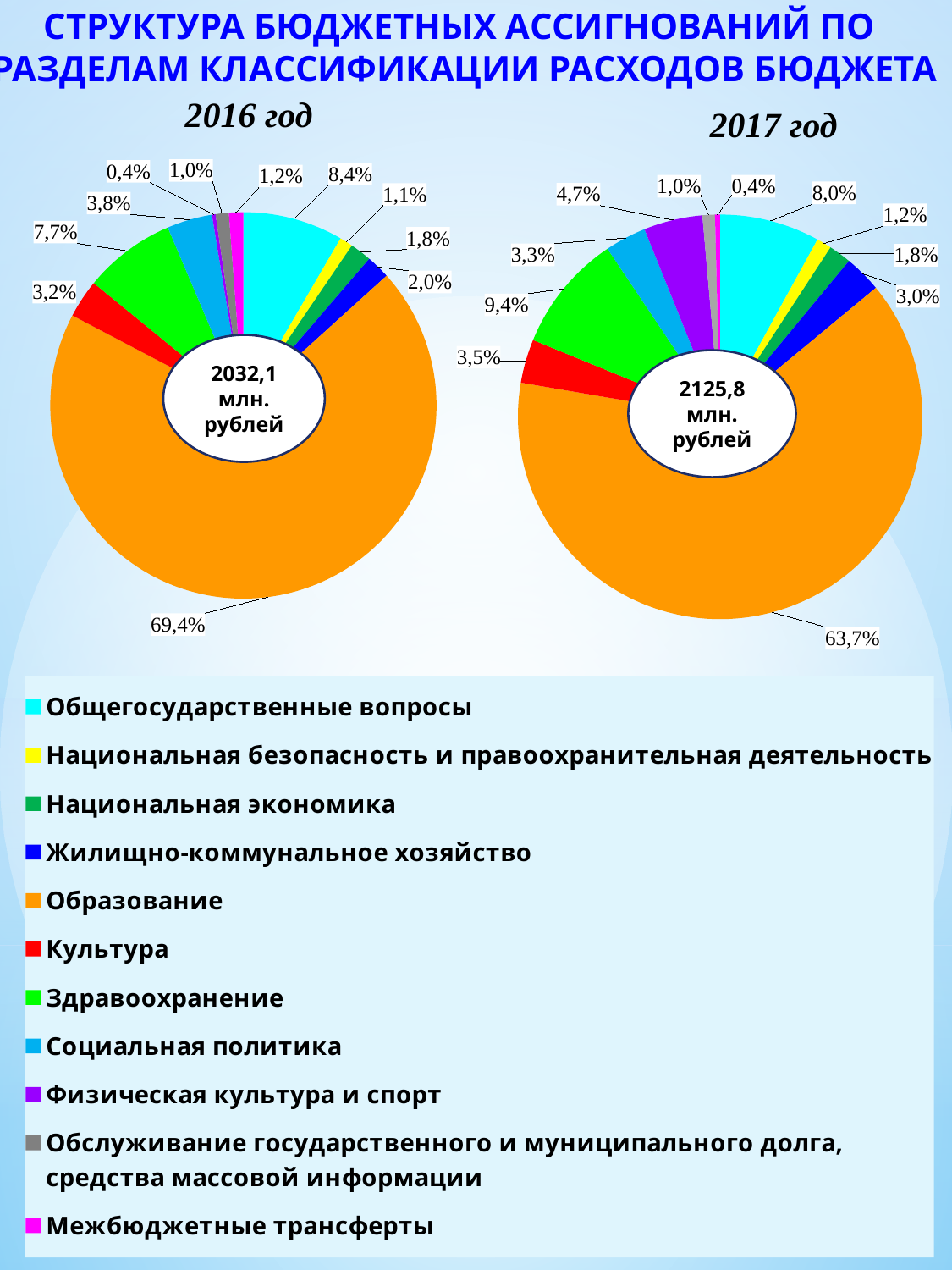
What kind of chart is used for the 2016 год and 2017 год data on the slide? Pie chart In the 2016 год pie chart, what share does Образование have? 69,4% Which category has the largest share in the 2017 год pie chart? Образование What total amount is shown in the centre of the 2017 год pie chart? 2125,8 млн. рублей In the 2017 год pie chart, what share does Здравоохранение have? 9,4% In the 2016 год pie chart, what share does Общегосударственные вопросы have? 8,4% In the 2016 год pie chart, which is larger: the share of Здравоохранение or the share of Социальная политика? Здравоохранение Which category has the smallest share in the 2016 год pie chart? Физическая культура и спорт In the 2017 год pie chart, what share does Физическая культура и спорт have? 4,7% How many categories does the legend list for the pie charts? 11 By how many percentage points did the share of Образование fall from the 2016 год chart to the 2017 год chart? 5,7 In the 2017 год pie chart, what share does Образование have? 63,7%